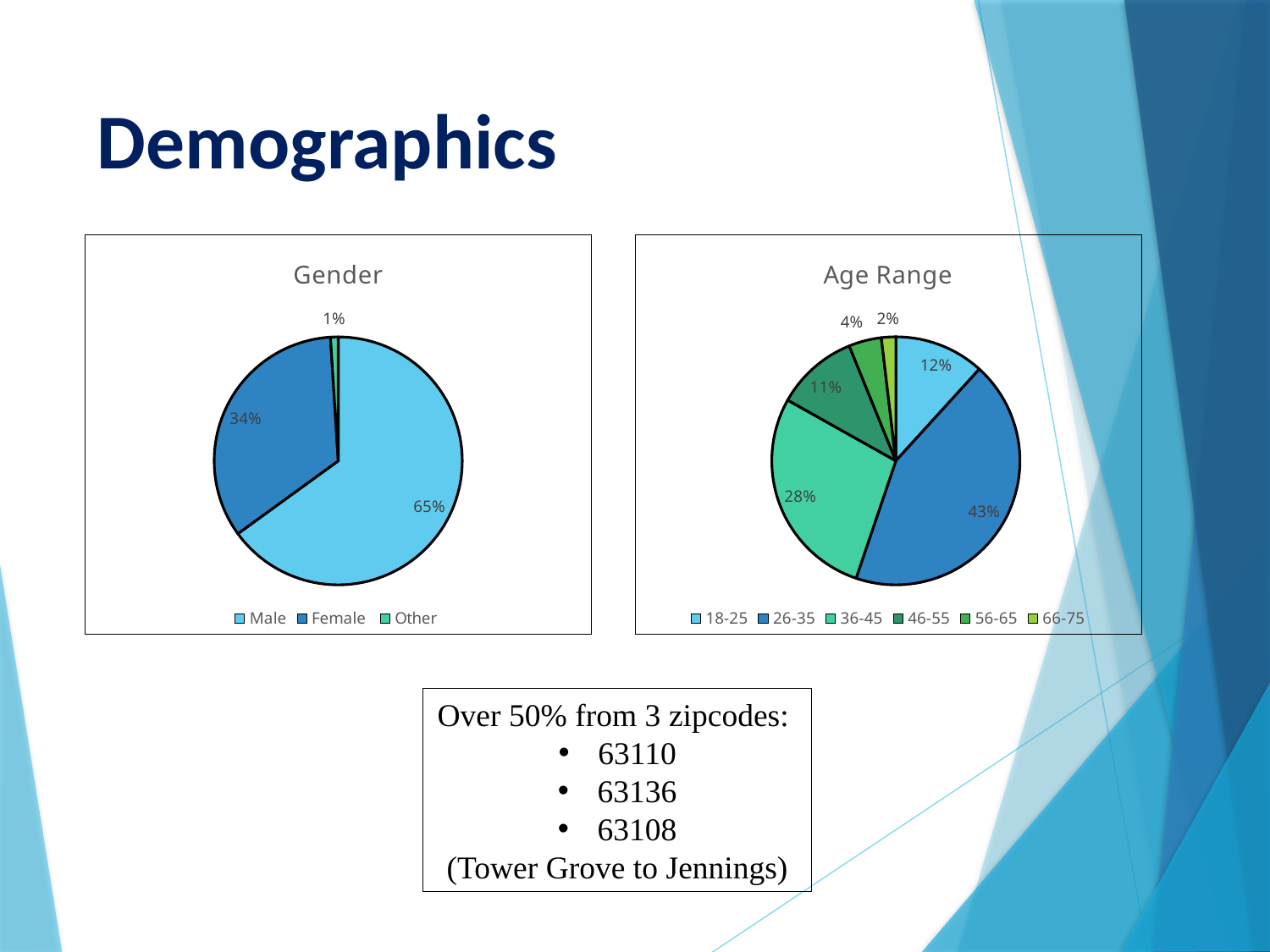
In the Gender chart, what percentage is labelled for Female? 34% In the Age Range chart, which age group has the largest slice? 26-35 What kind of chart is the Age Range chart? Pie chart In the Age Range chart, which age group has the smallest slice? 66-75 In the Gender chart, what share of the pie is Male? 65% In the Gender chart, what is the difference in percentage points between Male and Female? 31 In the Age Range chart, what percentage is shown for 36-45? 28% In the Age Range chart, how many age groups does the legend list? 6 In the Age Range chart, which is larger, the 18-25 slice or the 46-55 slice? 18-25 In the Gender chart, which category has the smallest slice? Other In the Age Range chart, what is the difference in percentage points between 26-35 and 36-45? 15 In the Gender chart, how many categories does the legend list? 3